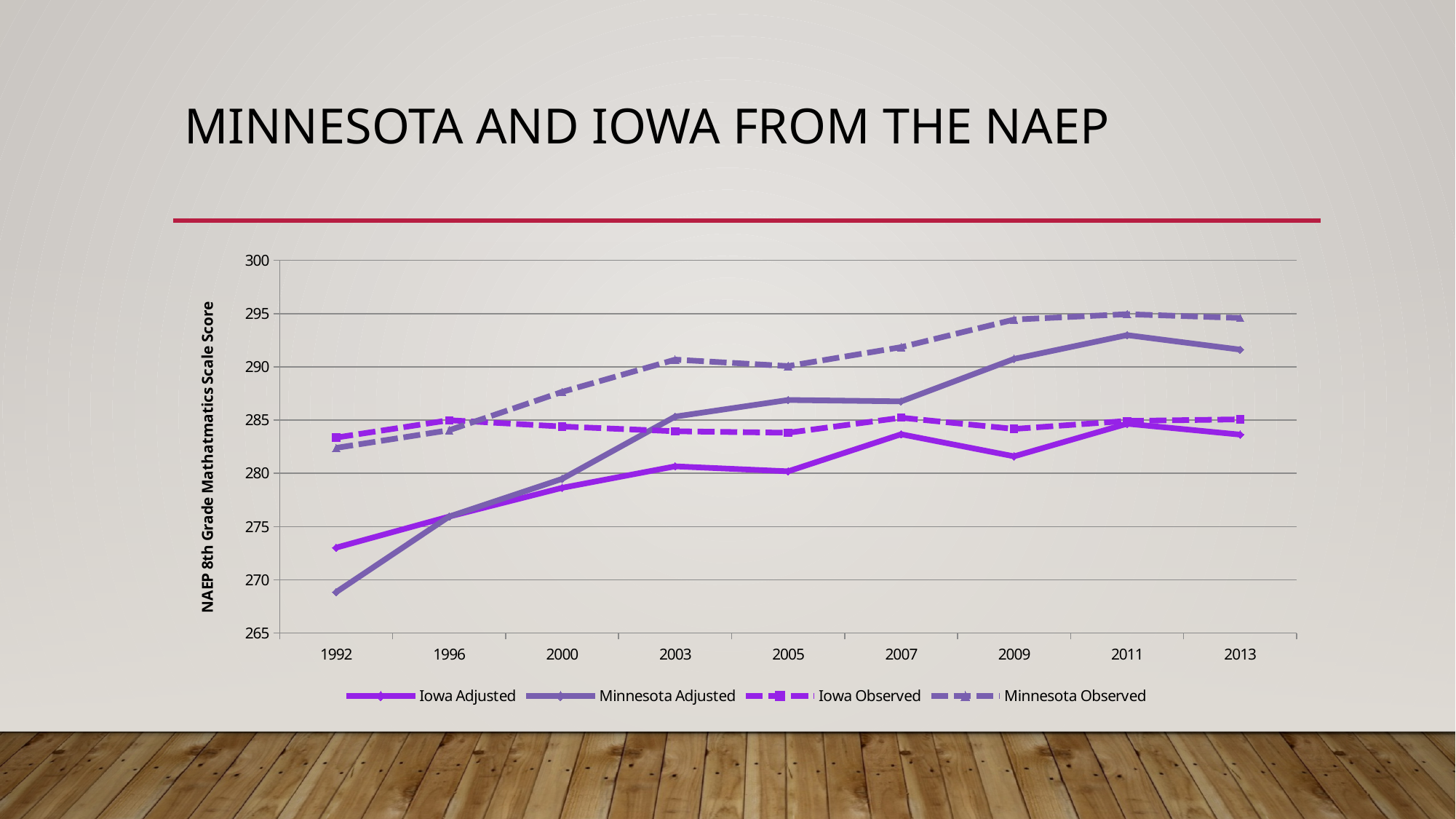
What kind of chart is shown on the slide? Line chart How many series does the legend list? 4 Which series has the highest value in 2013? Minnesota Observed Is the value for Iowa Adjusted in 1992 greater or less than 270? greater Is the value for Minnesota Adjusted in 2011 greater or less than 290? greater Which series has the lowest value in 1992? Minnesota Adjusted Is the value for Minnesota Adjusted in 1992 greater or less than 270? less What is the label of the vertical axis? NAEP 8th Grade Mathatmatics Scale Score In 2013, which is larger: Minnesota Adjusted or Iowa Adjusted? Minnesota Adjusted How many years are plotted along the x axis? 9